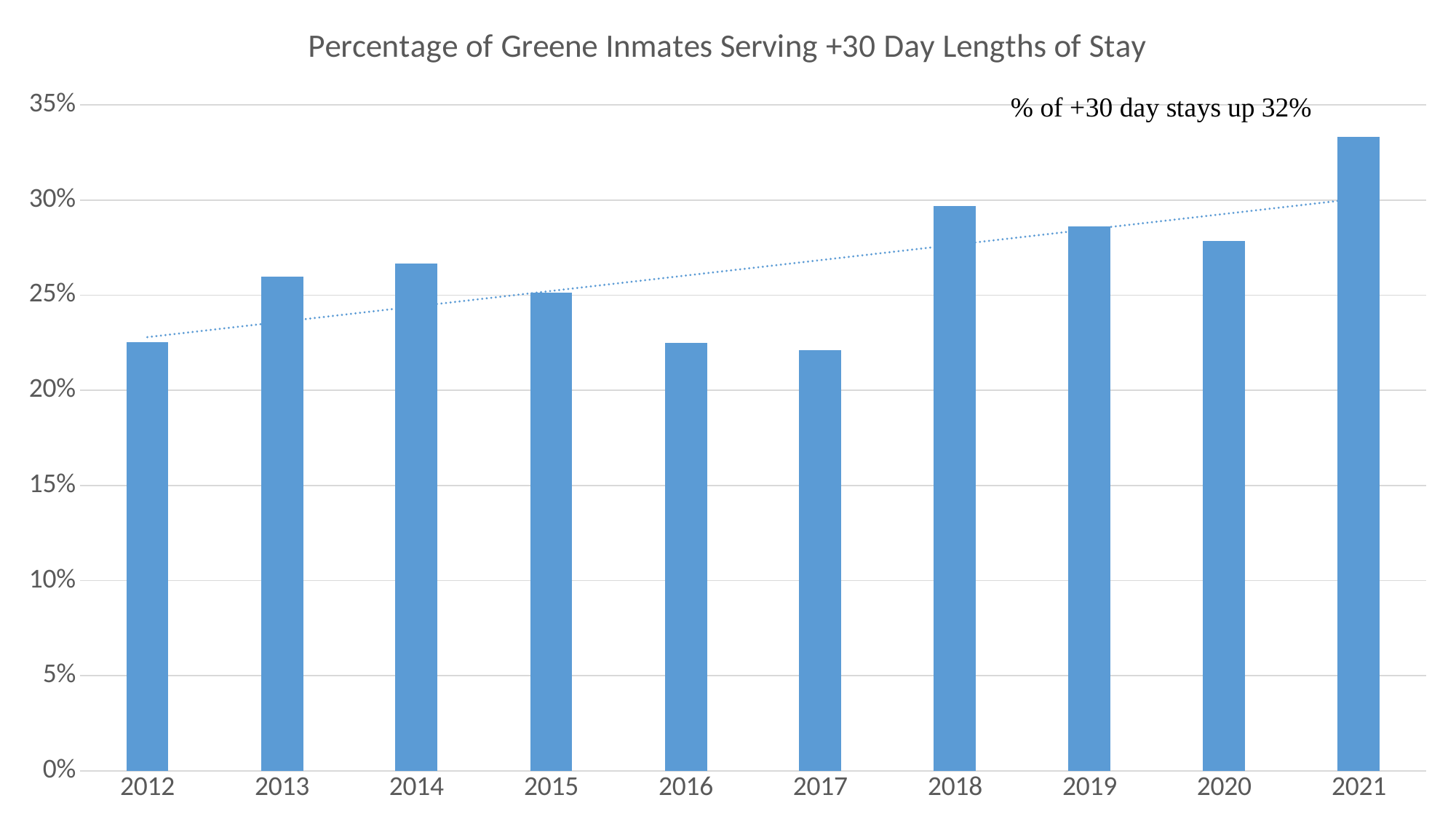
Which year has the highest percentage of Greene inmates serving +30 day lengths of stay? 2021 Which year has the larger value, 2018 or 2019? 2018 Is the value for 2021 greater or less than 30%? greater Is the value for 2017 greater or less than 20%? greater Is the value for 2012 greater or less than 25%? less How many years are plotted on the x axis? 10 What kind of chart is shown on the slide? Bar chart Overall, do the values rise or fall from 2012 to 2021? Rise Which year has the larger value, 2015 or 2016? 2015 What does the annotation text in the upper right of the chart say? % of +30 day stays up 32%